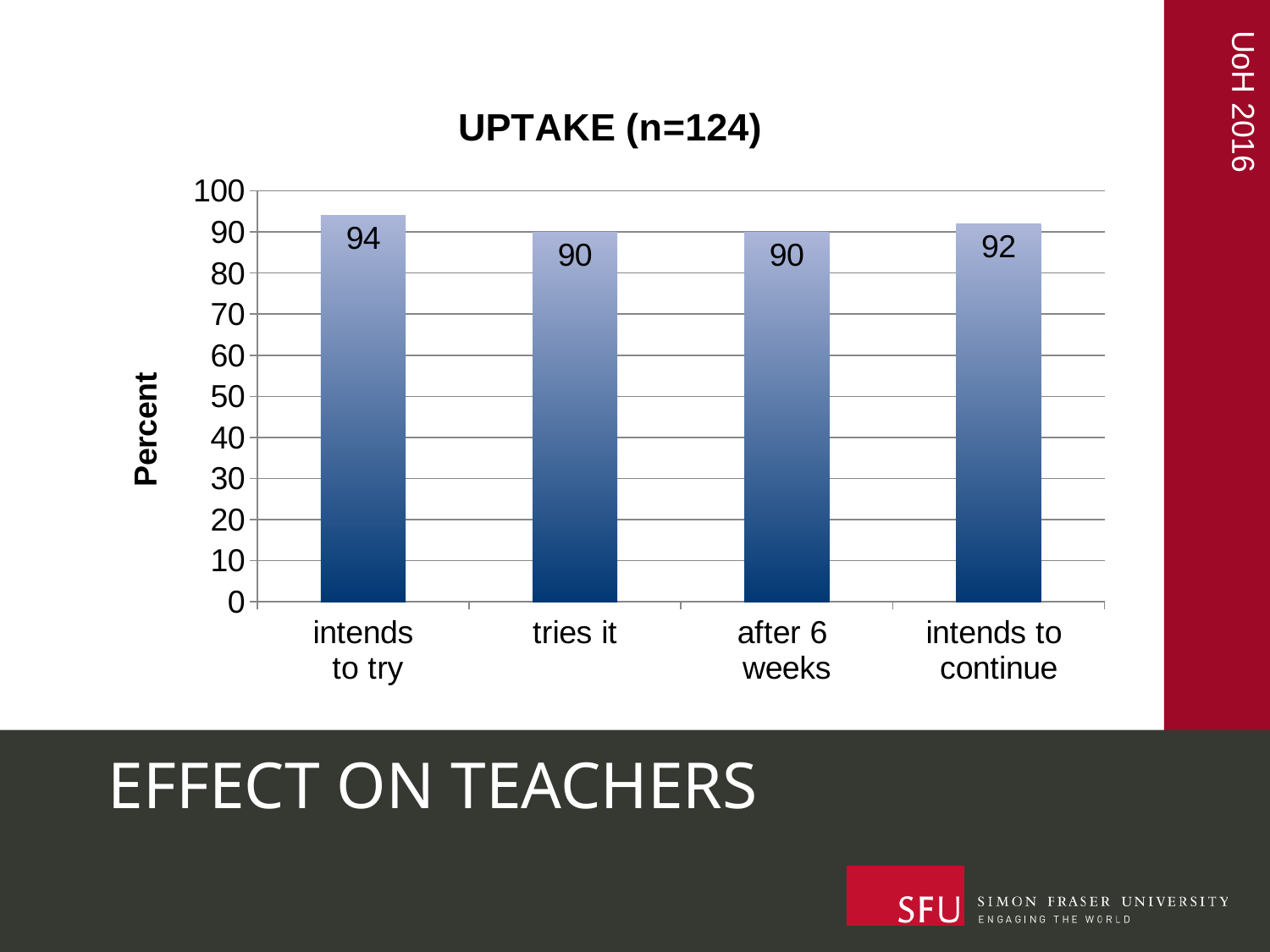
What is the difference between the values for "intends to continue" and "after 6 weeks"? 2 Is the value for "tries it" greater or less than 80? greater What is the value for "intends to continue"? 92 What is the value for "after 6 weeks"? 90 How many categories are shown on the x axis? 4 What is the difference between the values for "intends to try" and "tries it"? 4 What is the value for "intends to try"? 94 What kind of chart is shown? bar chart Which category has the highest value? intends to try Which is larger, the value for "intends to try" or the value for "intends to continue"? intends to try What is the title of the chart? UPTAKE (n=124) What is the value for "tries it"? 90